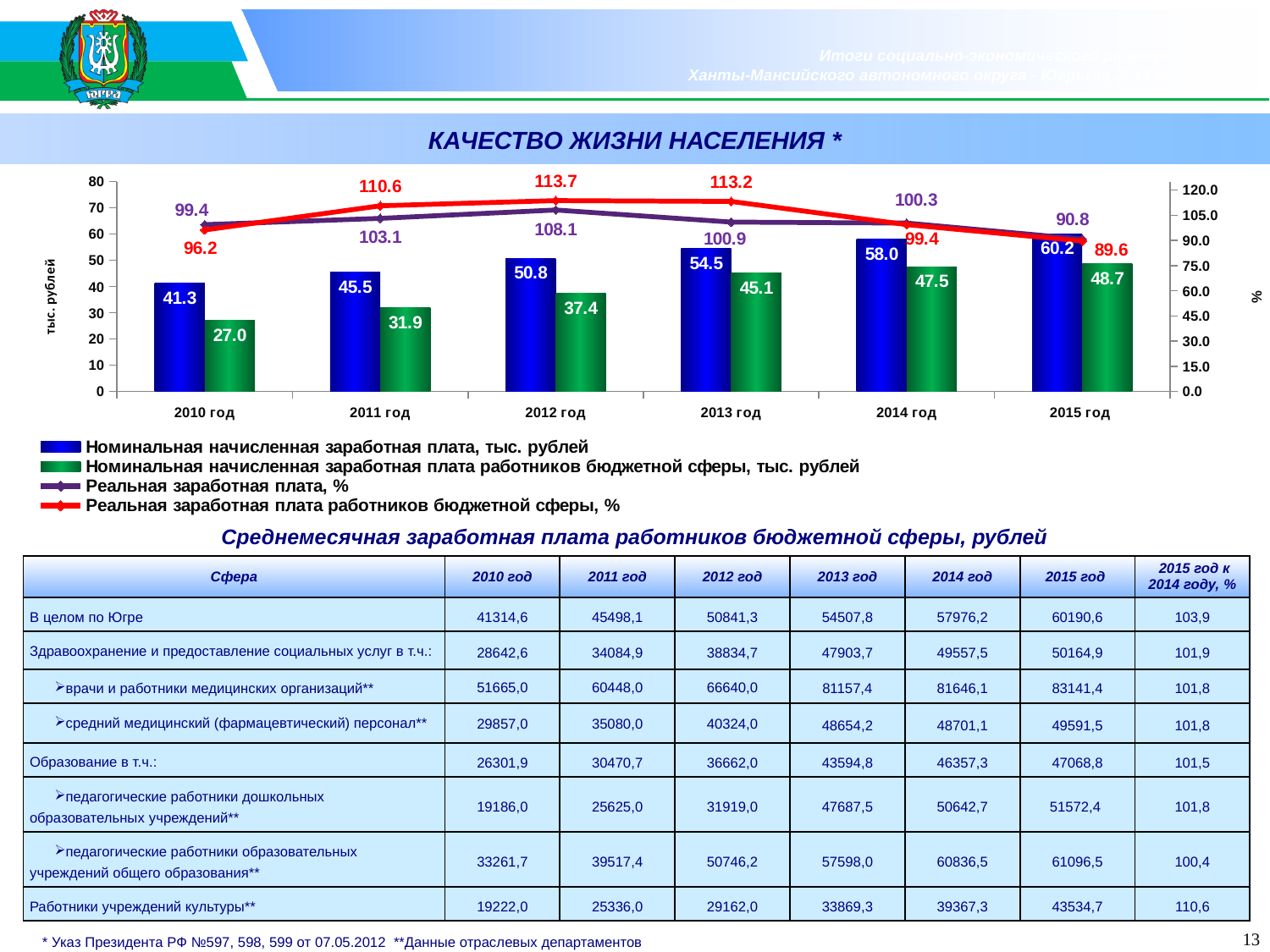
What is the title of the chart? КАЧЕСТВО ЖИЗНИ НАСЕЛЕНИЯ * What is the value of 'Номинальная начисленная заработная плата работников бюджетной сферы, тыс. рублей' for 2010 год? 27.0 In which year is 'Реальная заработная плата работников бюджетной сферы, %' the lowest? 2015 год Does 'Номинальная начисленная заработная плата работников бюджетной сферы, тыс. рублей' rise or fall from 2010 год to 2015 год? rise How many series does the chart legend list? 4 In which year is 'Номинальная начисленная заработная плата, тыс. рублей' the highest? 2015 год What is the value of 'Номинальная начисленная заработная плата, тыс. рублей' for 2015 год? 60.2 What is the value of 'Реальная заработная плата, %' for 2014 год? 100.3 What is the difference between 'Номинальная начисленная заработная плата, тыс. рублей' and 'Номинальная начисленная заработная плата работников бюджетной сферы, тыс. рублей' in 2013 год? 9.4 Which is larger in 2011 год: 'Реальная заработная плата, %' or 'Реальная заработная плата работников бюджетной сферы, %'? Реальная заработная плата работников бюджетной сферы, % How many years are shown on the x axis of the chart? 6 What is the value of 'Реальная заработная плата работников бюджетной сферы, %' for 2012 год? 113.7